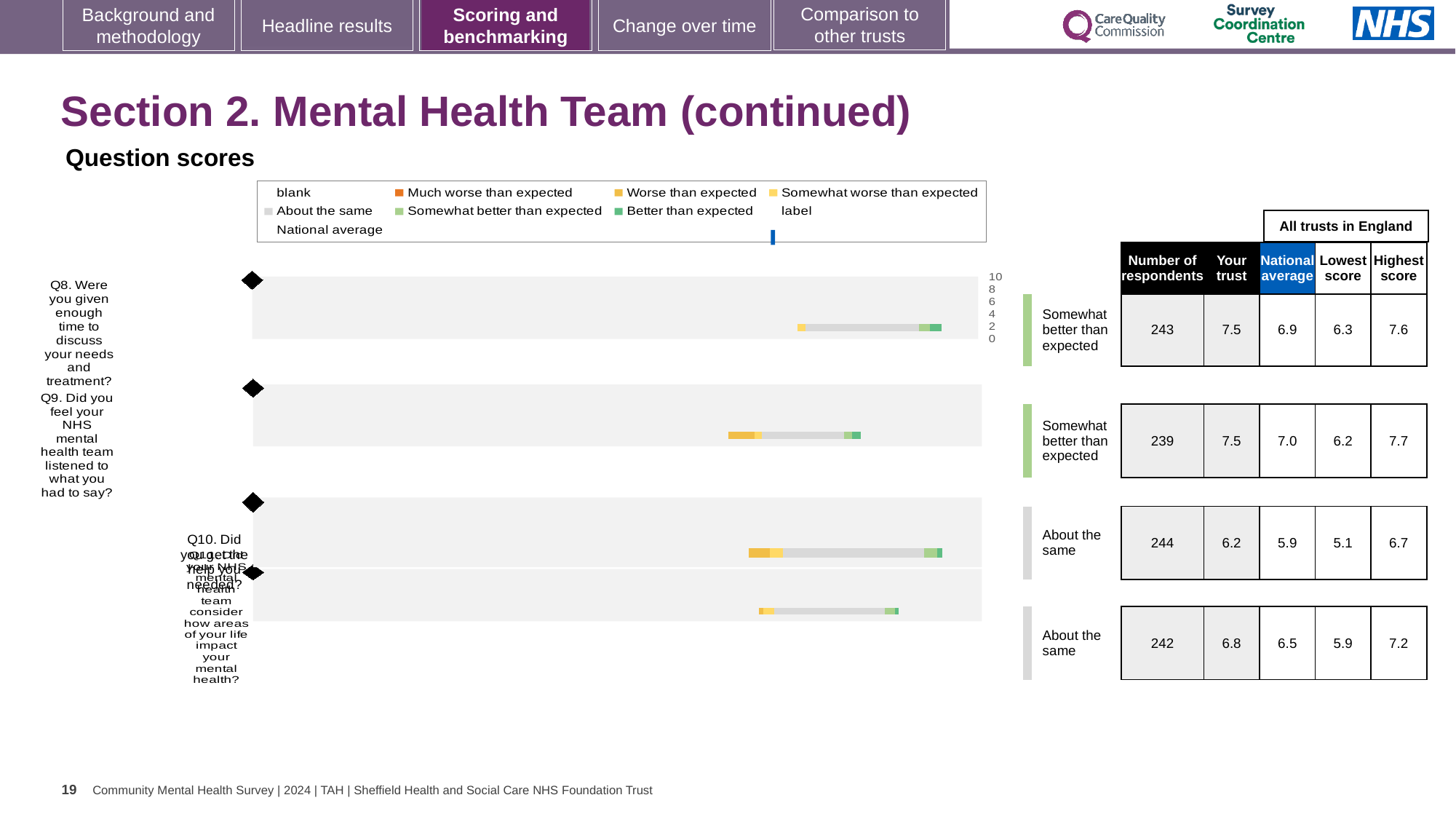
What is the 'Your trust' score for Q9 in the table beside the chart? 7.5 In the table next to the chart, what is the number of respondents for Q8? 243 For Q9, which is larger: the 'Your trust' score or the national average? Your trust What is the lowest score among all trusts in England for Q9? 6.2 In the chart legend, what colour represents 'Much worse than expected'? Orange What kind of chart is used to show the question scores on this slide? Bar chart By how much does the 'Your trust' score for Q10 exceed the national average for Q10? 0.3 What is the national average score for Q10 shown in the table? 5.9 Which question has the lowest 'Your trust' score in the table? Q10 What benchmark category is shown for Q8 next to the chart? Somewhat better than expected What is the highest score among all trusts in England for Q8? 7.6 How many question rows are plotted in the question scores chart? 4